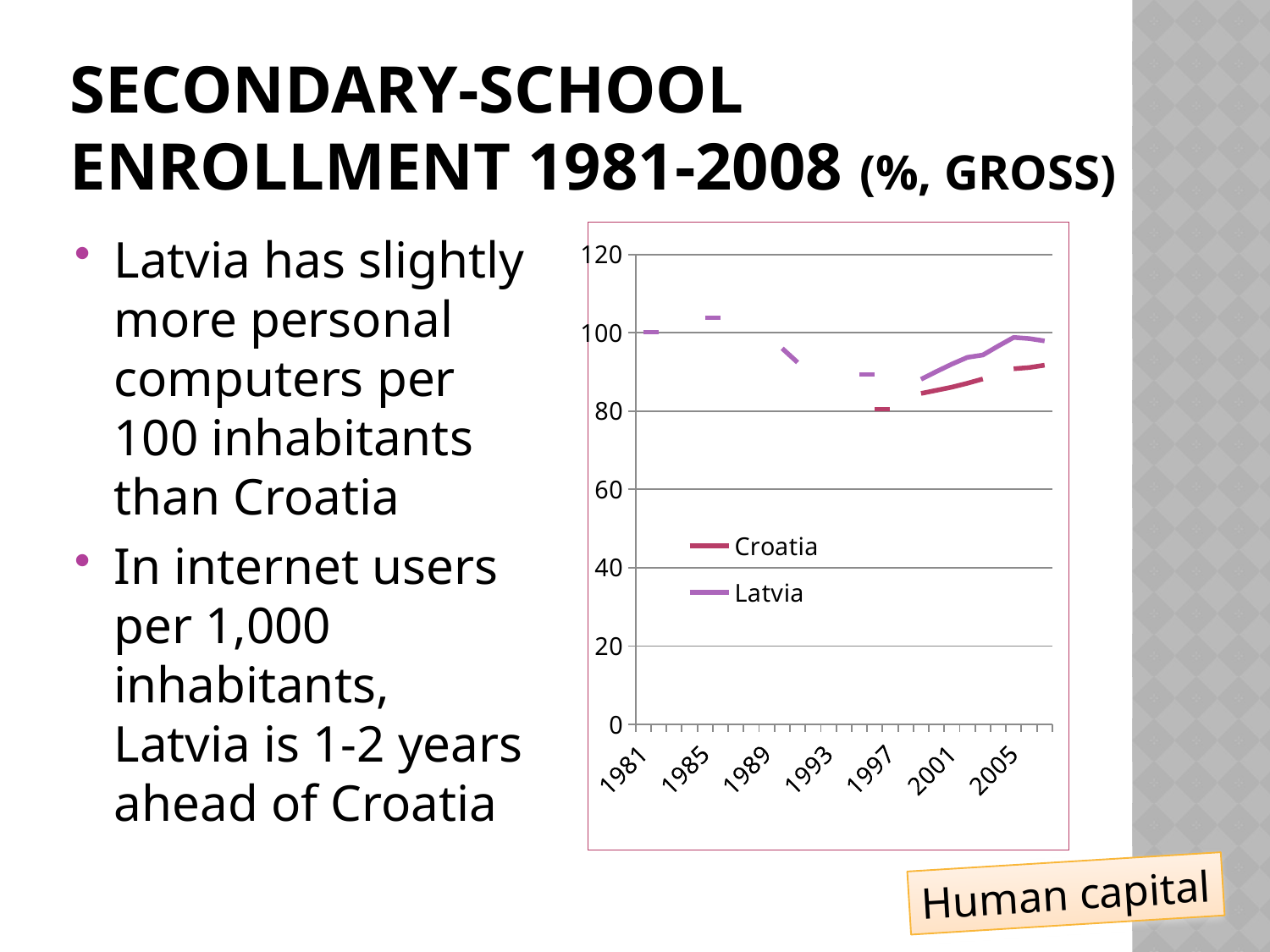
Which two countries are plotted in the chart? Croatia and Latvia What is the highest value shown on the vertical axis? 120 Is the value for Latvia in 1981 greater or less than 80? greater Is the value for Croatia in 1997 greater or less than 100? less In 2005, which series has the larger value, Croatia or Latvia? Latvia Is the value for Latvia in 1985 greater or less than 100? greater What kind of chart is shown on the slide? line chart How many series does the legend list? 2 Does the Croatia series rise or fall between 1997 and 2008? rise Does the Latvia series rise or fall between 1985 and 1997? fall